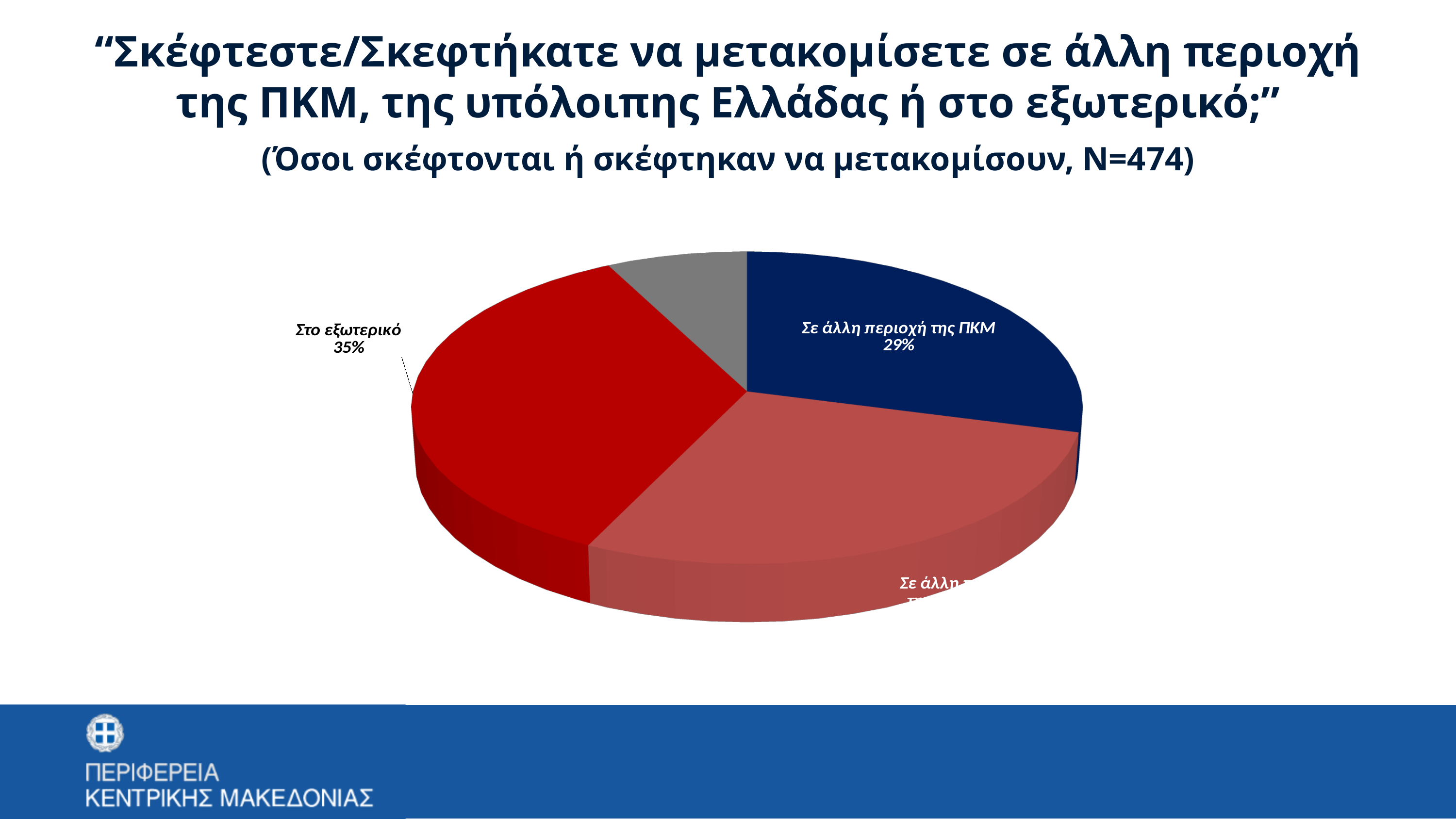
By how many percentage points does "Στο εξωτερικό" exceed "Σε άλλη περιοχή της ΠΚΜ"? 6 percentage points What percentage of the pie chart is labelled "Σε άλλη περιοχή της ΠΚΜ"? 29% What colour is the "Στο εξωτερικό" slice of the pie chart? Red Which slice is larger, "Στο εξωτερικό" or "Σε άλλη περιοχή της ΠΚΜ"? Στο εξωτερικό What percentage of the pie chart is labelled "Στο εξωτερικό"? 35% What kind of chart is shown on the slide? Pie chart What colour is the "Σε άλλη περιοχή της ΠΚΜ" slice of the pie chart? Dark blue How many slices does the pie chart have? 4